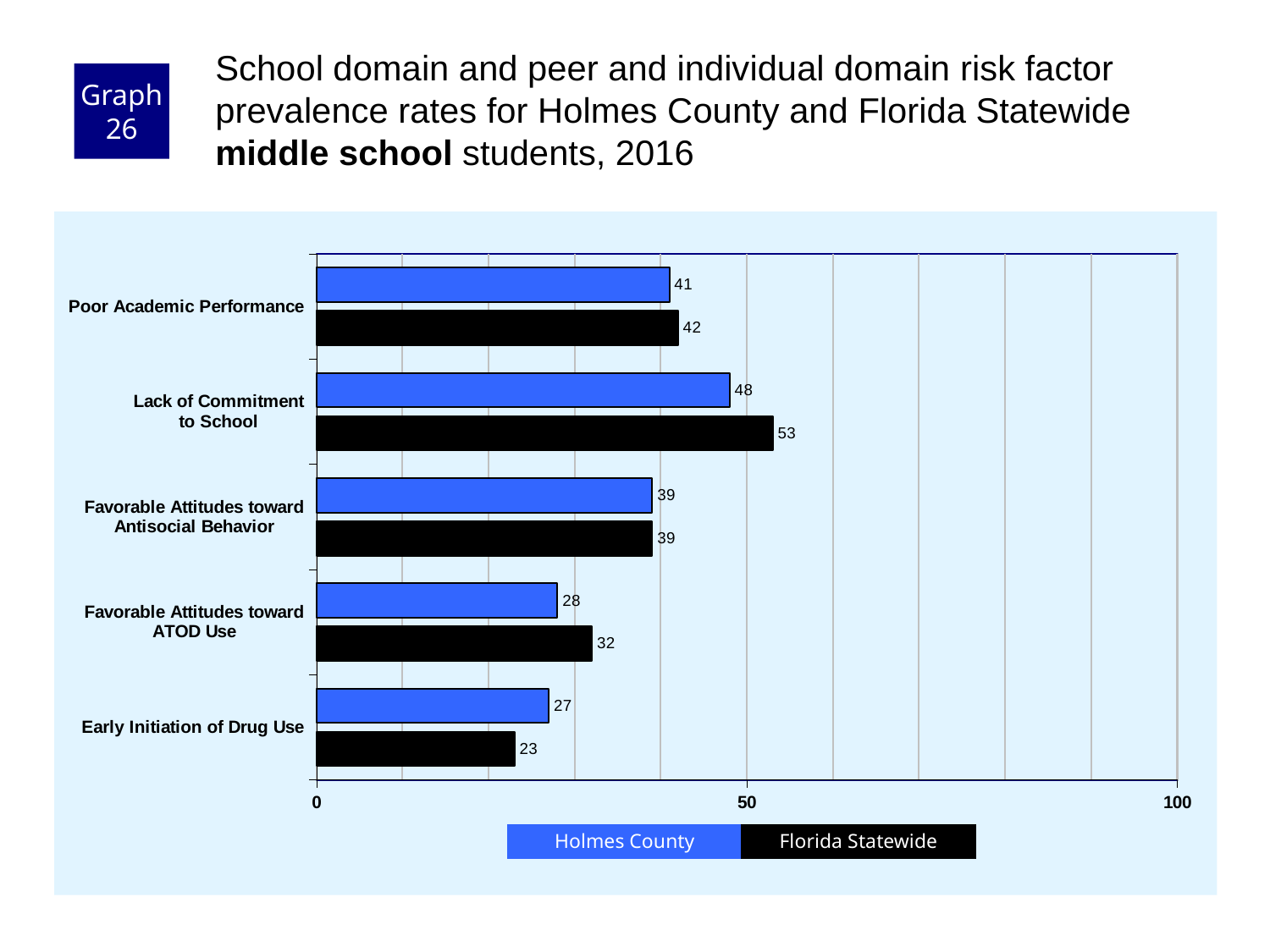
What is the difference between the Florida Statewide and Holmes County values for Lack of Commitment to School? 5 Which risk factor has the highest Florida Statewide value? Lack of Commitment to School Which risk factor has the lowest Holmes County value? Early Initiation of Drug Use How many series does the legend list? 2 What is the Holmes County value for Lack of Commitment to School? 48 What is the difference between the Holmes County and Florida Statewide values for Early Initiation of Drug Use? 4 Is the Florida Statewide value for Lack of Commitment to School greater or less than 50? greater What is the Florida Statewide value for Favorable Attitudes toward ATOD Use? 32 For Favorable Attitudes toward ATOD Use, which is larger: the Holmes County value or the Florida Statewide value? Florida Statewide How many risk factors are shown on the chart? 5 What is the Florida Statewide value for Early Initiation of Drug Use? 23 What kind of chart is shown on the slide? bar chart